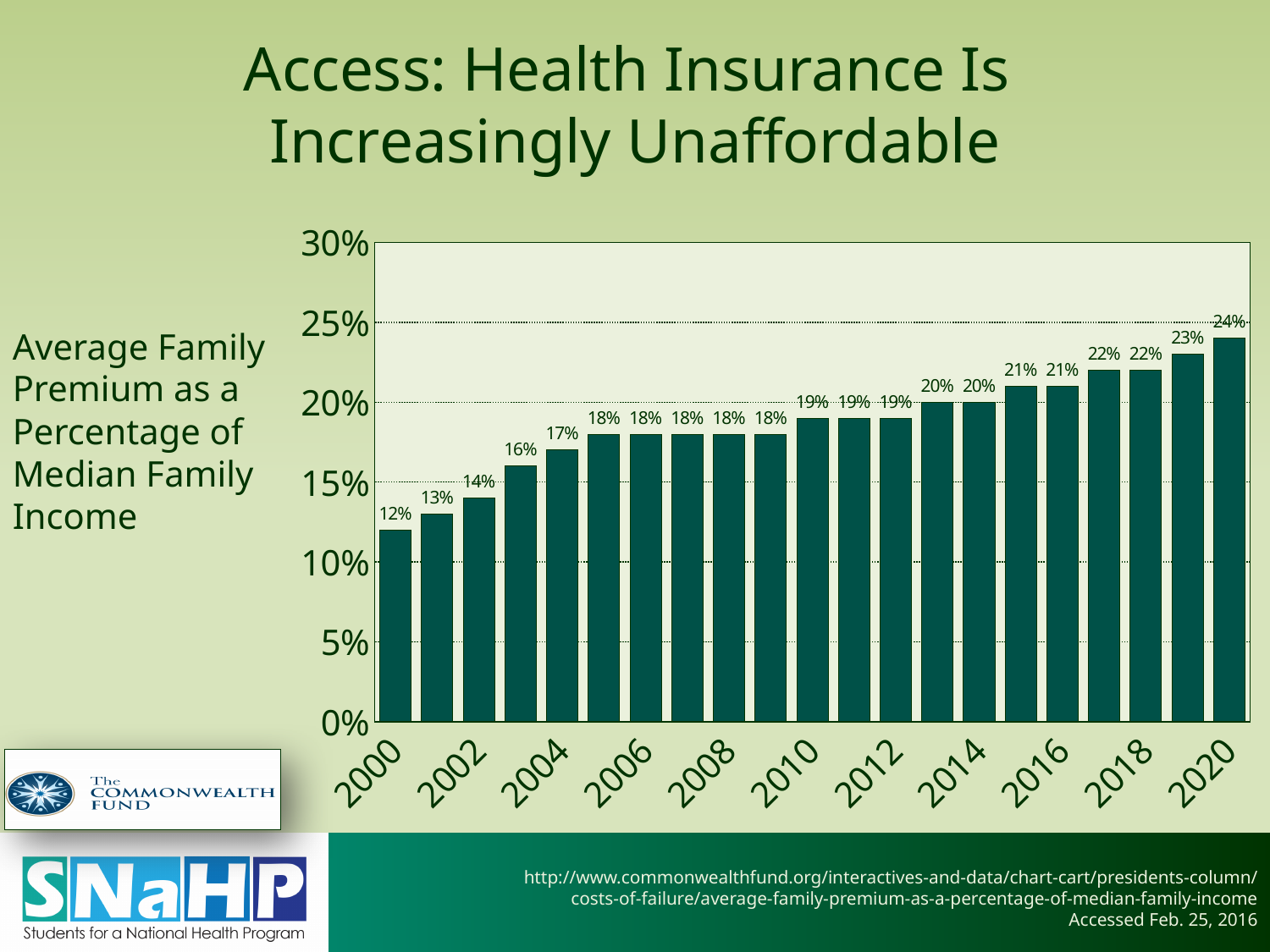
What is the value for 2020? 24% What kind of chart is shown on the slide? bar chart Which year has the lowest value? 2000 Which year has the highest value? 2020 What is the value for 2004? 17% Is the value for 2018 greater or less than 20%? greater What is the value for 2000? 12% What is the difference between the values for 2020 and 2000? 12% Do the values rise or fall from 2000 to 2020? rise How many bars are plotted in the chart? 21 Which is larger, the value for 2016 or the value for 2012? 2016 What is the value for 2010? 19%